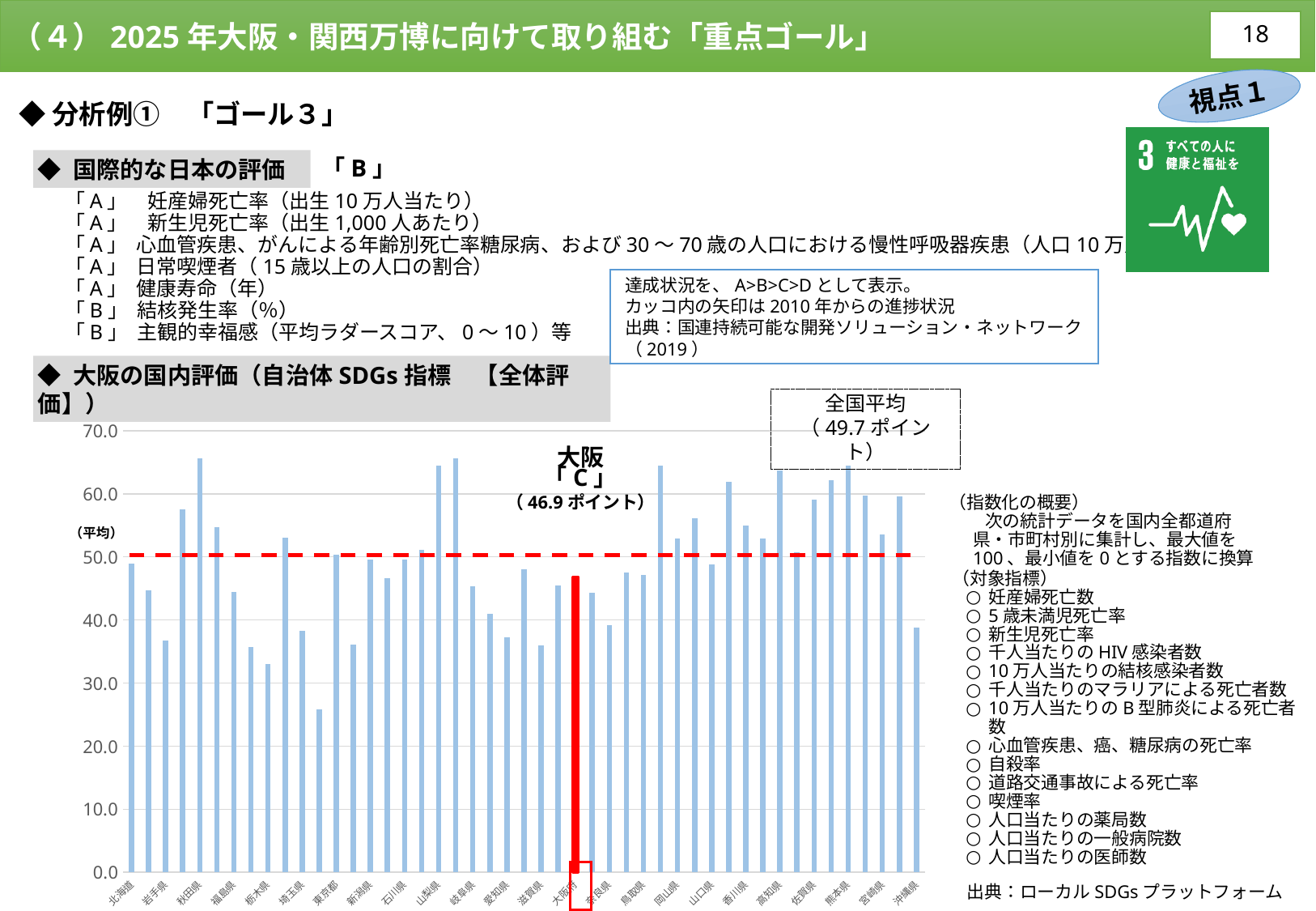
What does the red dashed horizontal line on the chart represent? 全国平均（49.7 ポイント） What rating is given to 大阪 on the chart? 「C」 Is the value for 栃木県 greater or less than 40.0? less Which has the larger value on the chart, 秋田県 or 東京都? 秋田県 Which is larger, the value for 大阪 or the 全国平均? 全国平均 What is the value shown for 大阪 on the bar chart? 46.9 ポイント Is the value for 秋田県 greater or less than 60.0? greater Is the value for 大阪府 greater or less than 50.0? less By how many points is 大阪 below the 全国平均 on the chart? 2.8 ポイント What kind of chart is shown on the slide? Bar chart What is the 全国平均 value shown on the chart? 49.7 ポイント